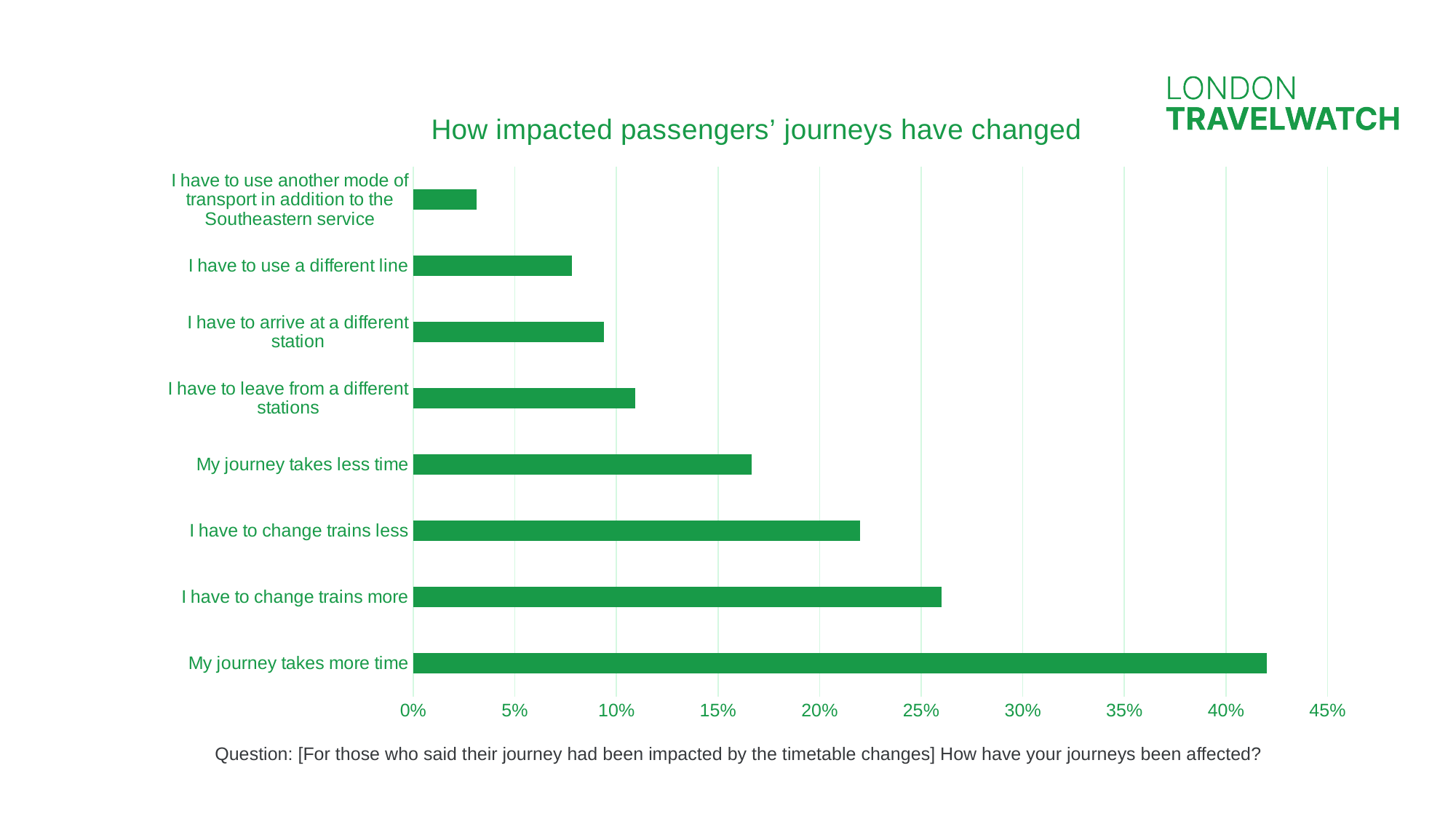
Is the value for "My journey takes less time" greater or less than 15%? greater Is the value for "I have to change trains more" greater or less than 30%? less Is the value for "My journey takes more time" greater or less than 40%? greater What is the title of the chart? How impacted passengers' journeys have changed Which category has the lowest value? I have to use another mode of transport in addition to the Southeastern service Which is larger: the value for "I have to change trains more" or "I have to change trains less"? I have to change trains more What kind of chart is shown on the slide? bar chart How many categories are plotted in the chart? 8 Which category has the highest value? My journey takes more time